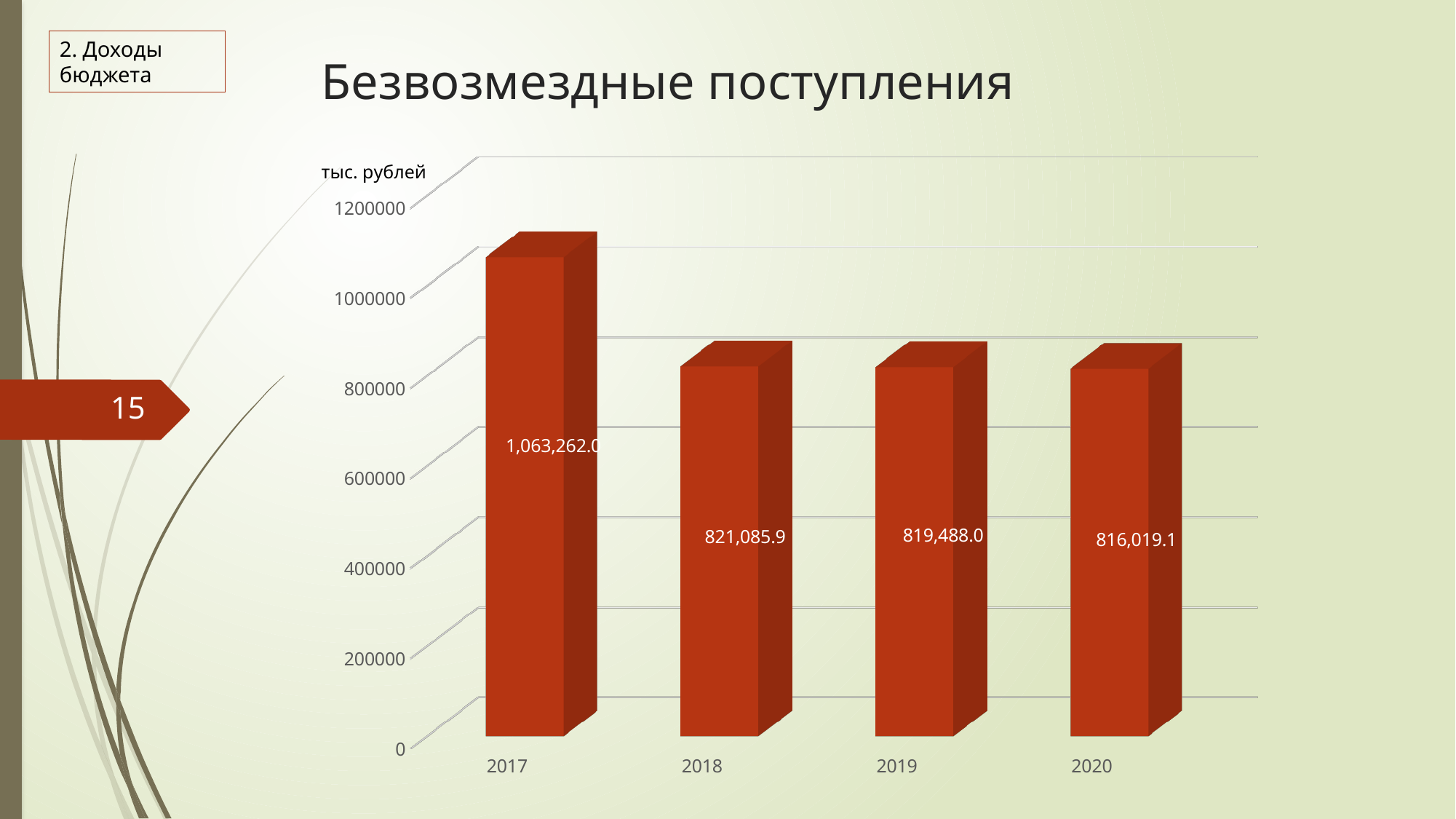
What is the value for 2019? 819,488.0 Which year has the highest value? 2017 Which year has the lowest value according to the data labels? 2020 What is the difference between the values for 2017 and 2018? 242,176.1 What is the value for 2017? 1,063,262.0 Which is larger, the value for 2017 or the value for 2020? 2017 What is the value for 2020? 816,019.1 What kind of chart is shown on the slide? bar chart Is the value for 2019 greater or less than 1000000? less How many years are shown on the x axis? 4 What is the difference between the values for 2018 and 2020? 5,066.8 What is the value for 2018? 821,085.9